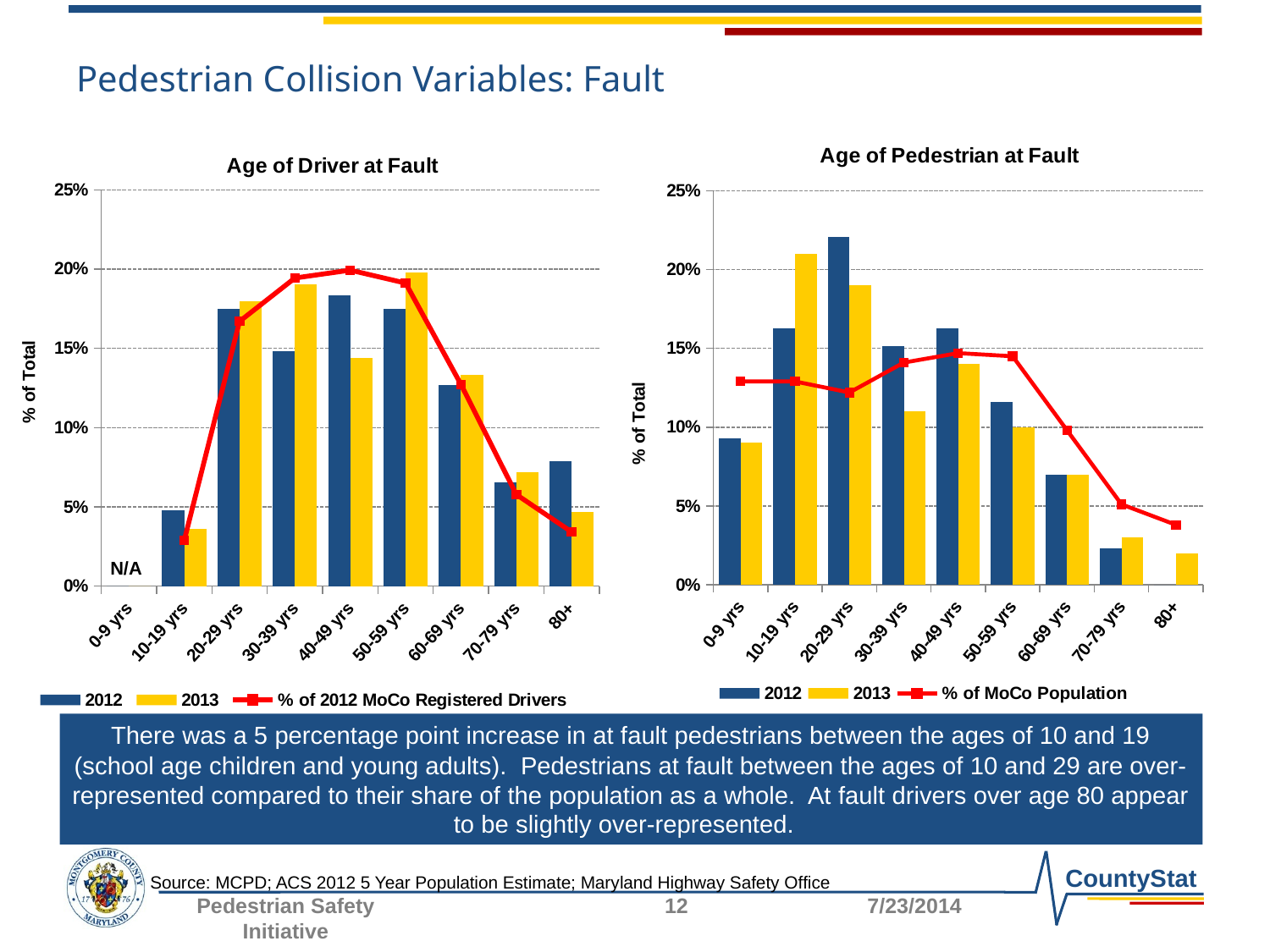
What kind of chart is the 'Age of Driver at Fault' chart? combination bar and line chart In the 'Age of Driver at Fault' chart, is the 2012 value for 40-49 yrs greater or less than 15%? greater In the 'Age of Driver at Fault' chart, is the 2012 value for 80+ greater or less than 5%? greater In the 'Age of Pedestrian at Fault' chart, which is larger for 10-19 yrs, the 2012 value or the 2013 value? 2013 In the 'Age of Pedestrian at Fault' chart, which age group has the highest 2012 value? 20-29 yrs In the 'Age of Driver at Fault' chart, which age group is marked N/A? 0-9 yrs In the 'Age of Pedestrian at Fault' chart, which age group has the highest 2013 value? 10-19 yrs How many age groups are shown on the x axis of the 'Age of Driver at Fault' chart? 9 How many series does the legend of the 'Age of Pedestrian at Fault' chart list? 3 In the 'Age of Pedestrian at Fault' chart, is the 2012 value for 70-79 yrs greater or less than 5%? less In the 'Age of Driver at Fault' chart, which is larger for 40-49 yrs, the 2012 value or the 2013 value? 2012